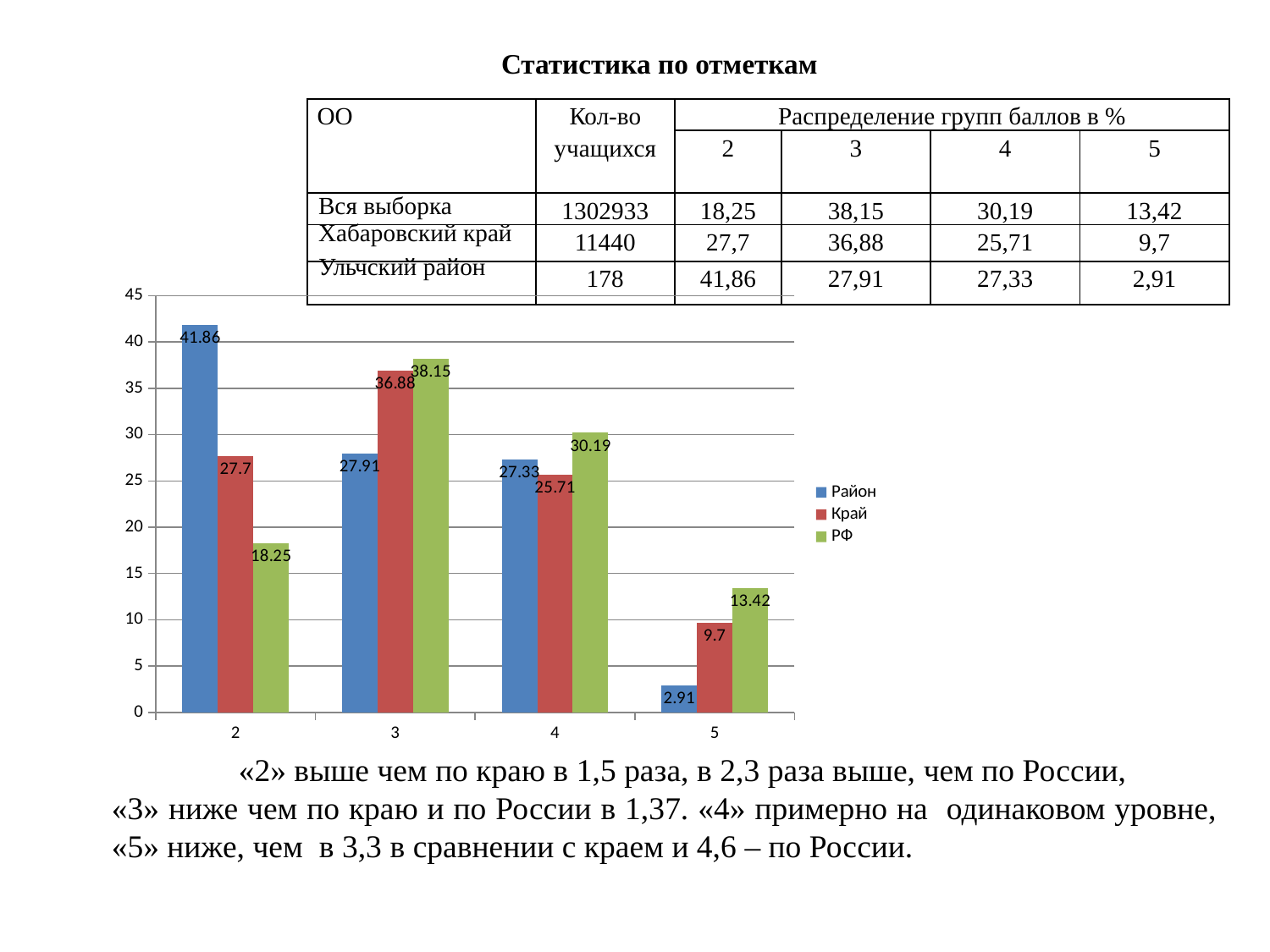
Which colour represents the РФ series in the legend? green What is the value for Район at category 2? 41.86 How many categories are shown on the x axis? 4 Which category has the lowest value for the Край series? 5 What is the difference between the РФ and Район values at category 5? 10.51 What is the value for Край at category 3? 36.88 What kind of chart is shown on the slide? bar chart Is the value for Край at category 2 greater or less than 25? greater At category 3, which series has the larger value, Район or РФ? РФ How many series does the legend list? 3 What is the value for РФ at category 5? 13.42 Which category has the highest value for the Район series? 2